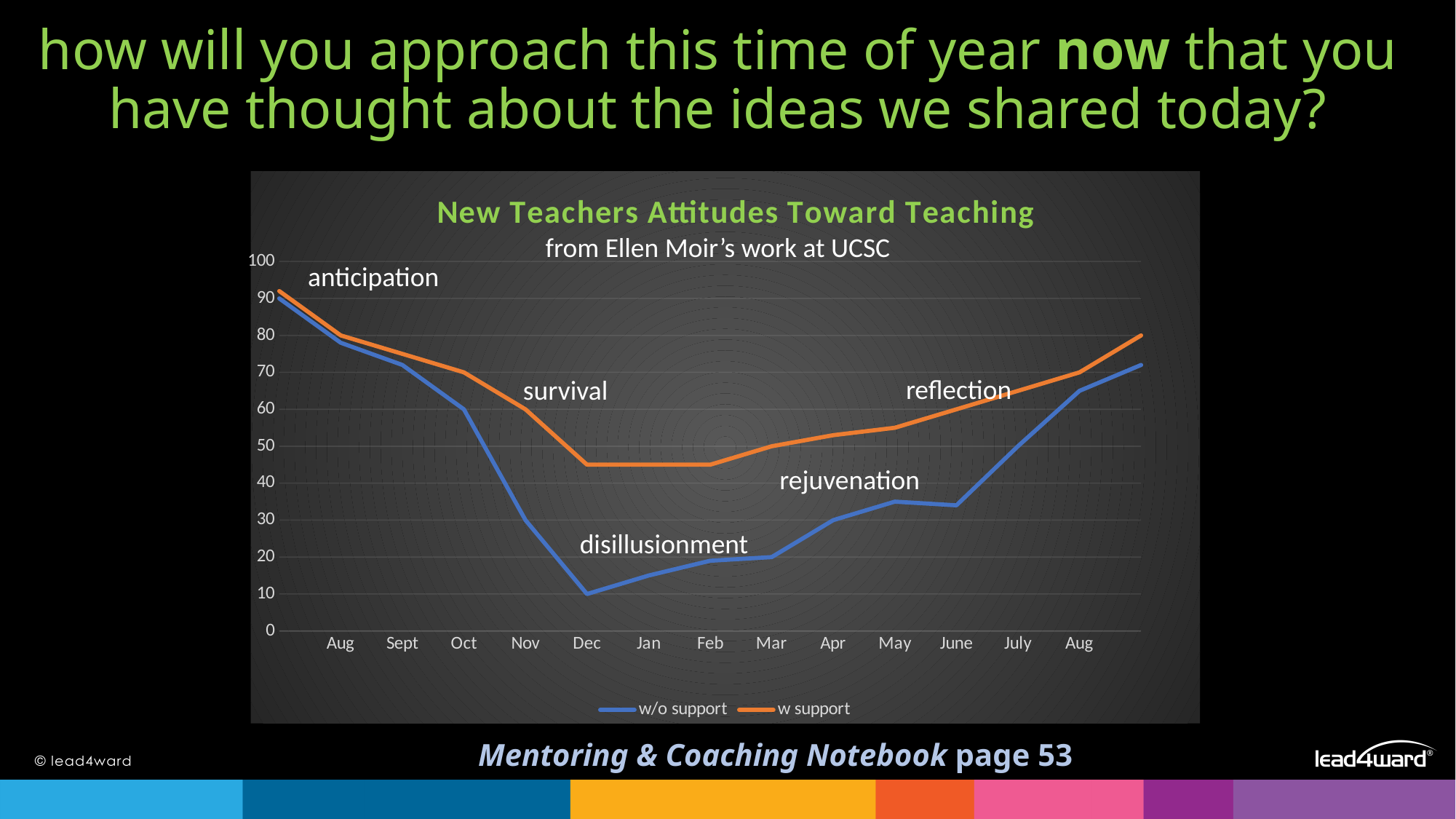
What is the value of the w/o support line in Dec? 10 In which month does the w/o support line reach its lowest value? Dec What type of chart is shown on the slide? line chart How many months are shown along the x axis? 13 What is the value of the w support line in Oct? 70 Is the value for w support in Feb greater or less than 40? greater How many series does the legend list? 2 Does the w/o support line rise or fall from Aug to Dec? fall Which series is drawn in orange? w support Is the value for w/o support in Nov greater or less than 40? less What is the title of the chart? New Teachers Attitudes Toward Teaching In Nov, which series has the larger value, w/o support or w support? w support